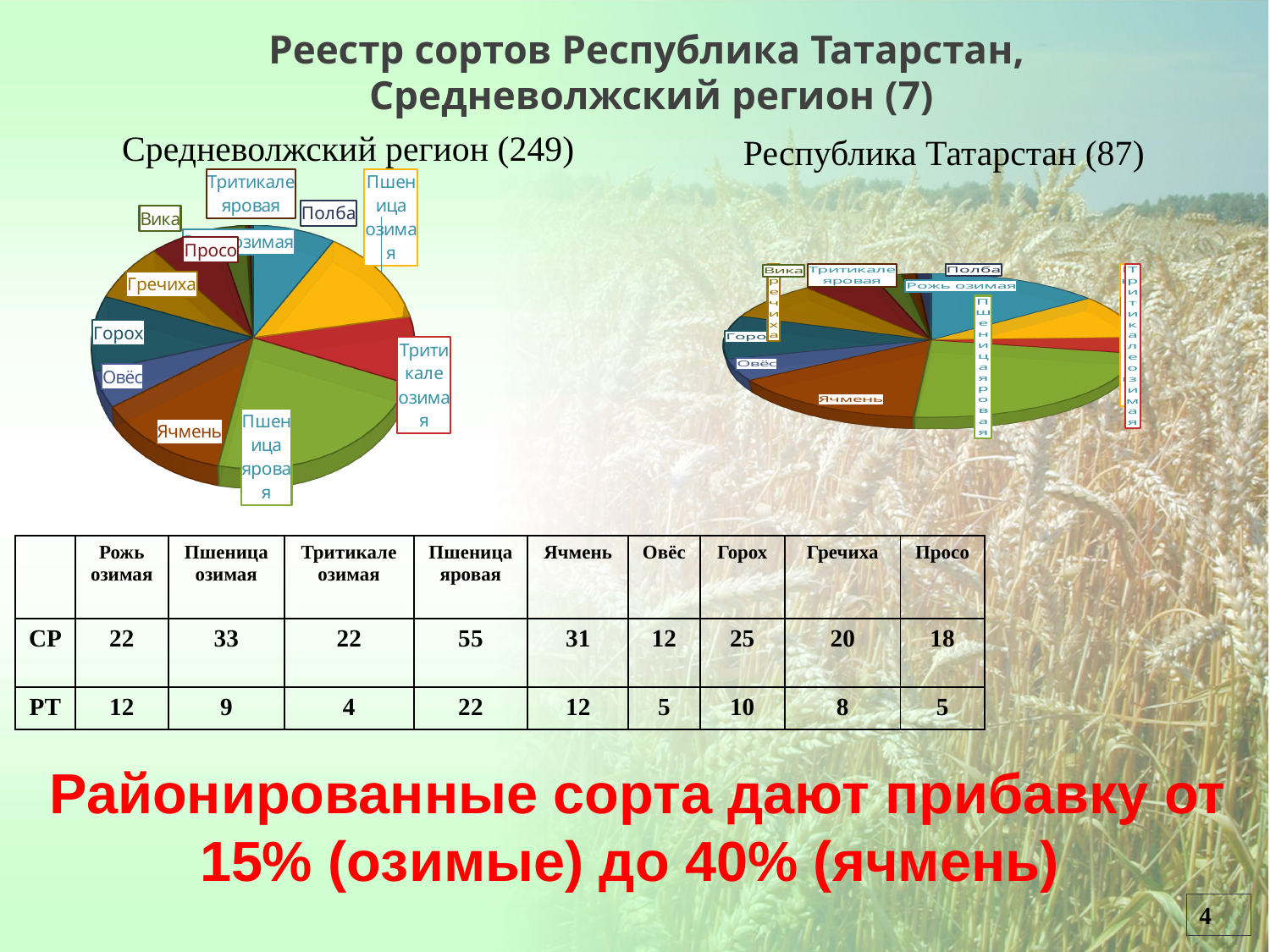
In the Республика Татарстан (87) pie chart, which category has the largest slice? Пшеница яровая What kind of chart is used for the Средневолжский регион (249) chart? pie chart What is the title of the left-hand pie chart? Средневолжский регион (249) In the Средневолжский регион (249) pie chart, which category has the largest slice? Пшеница яровая How many slices does the Средневолжский регион (249) pie chart have? 12 What is the value for Пшеница яровая in the Средневолжский регион (СР) data? 55 What is the difference between the СР and РТ values for Пшеница яровая? 33 What total number is shown in the title of the right-hand pie chart? 87 What is the value for Тритикале озимая in the Республика Татарстан (РТ) data? 4 Which is larger in the Средневолжский регион (СР) data: Горох or Гречиха? Горох Which is larger in the Республика Татарстан (РТ) data: Рожь озимая or Пшеница озимая? Рожь озимая What is the value for Ячмень in the Республика Татарстан (РТ) data? 12